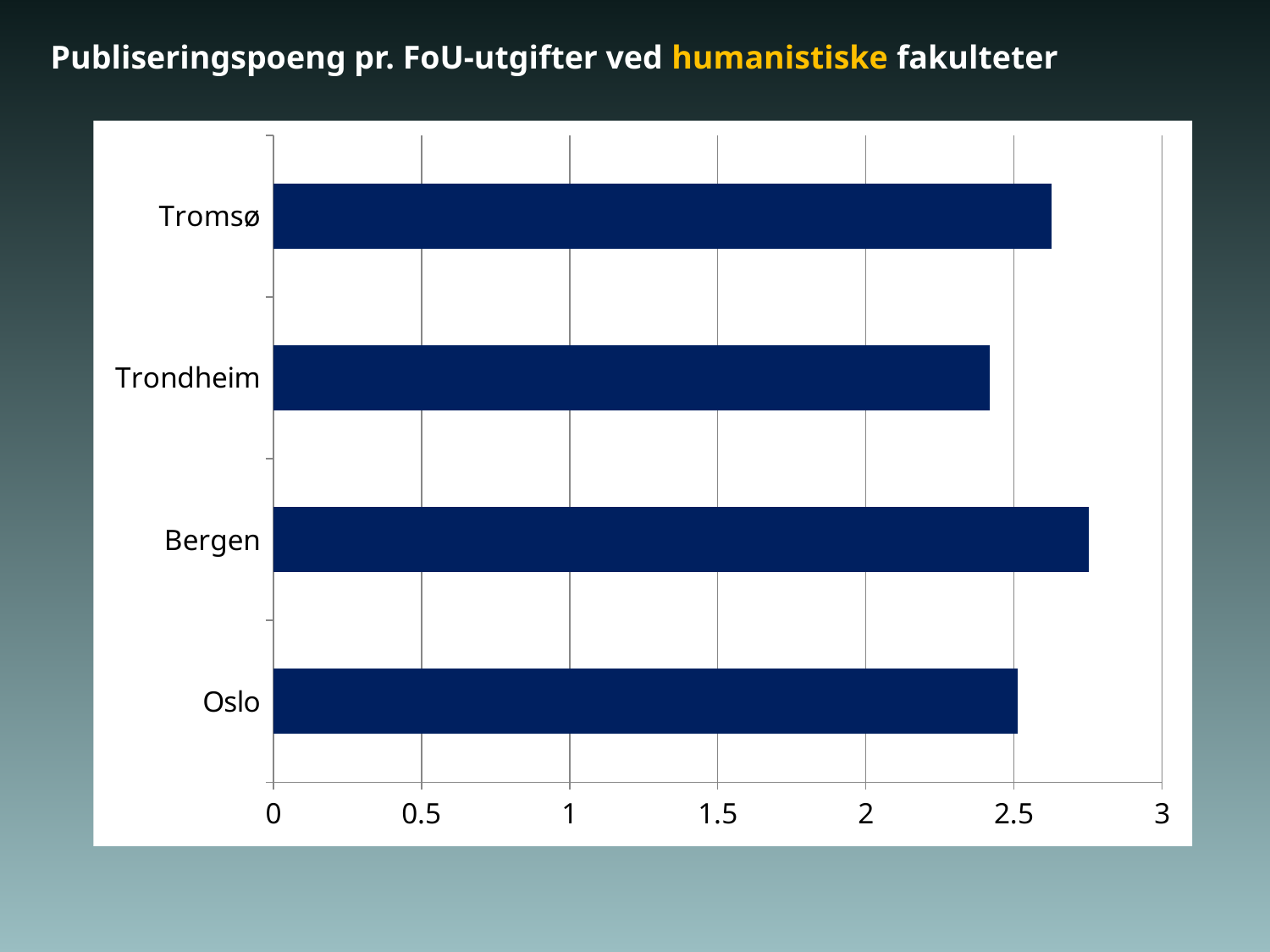
Is the value for Tromsø greater or less than 2.5? greater Is the value for Bergen greater or less than 2.5? greater Which city has the lowest value on the chart? Trondheim Which has the larger value, Bergen or Oslo? Bergen Which city has the highest value on the chart? Bergen What kind of chart is shown on the slide? bar chart Which has the larger value, Bergen or Trondheim? Bergen Is the value for Oslo greater or less than 2? greater Which has the larger value, Tromsø or Trondheim? Tromsø What is the title of the slide? Publiseringspoeng pr. FoU-utgifter ved humanistiske fakulteter How many cities are shown on the chart? 4